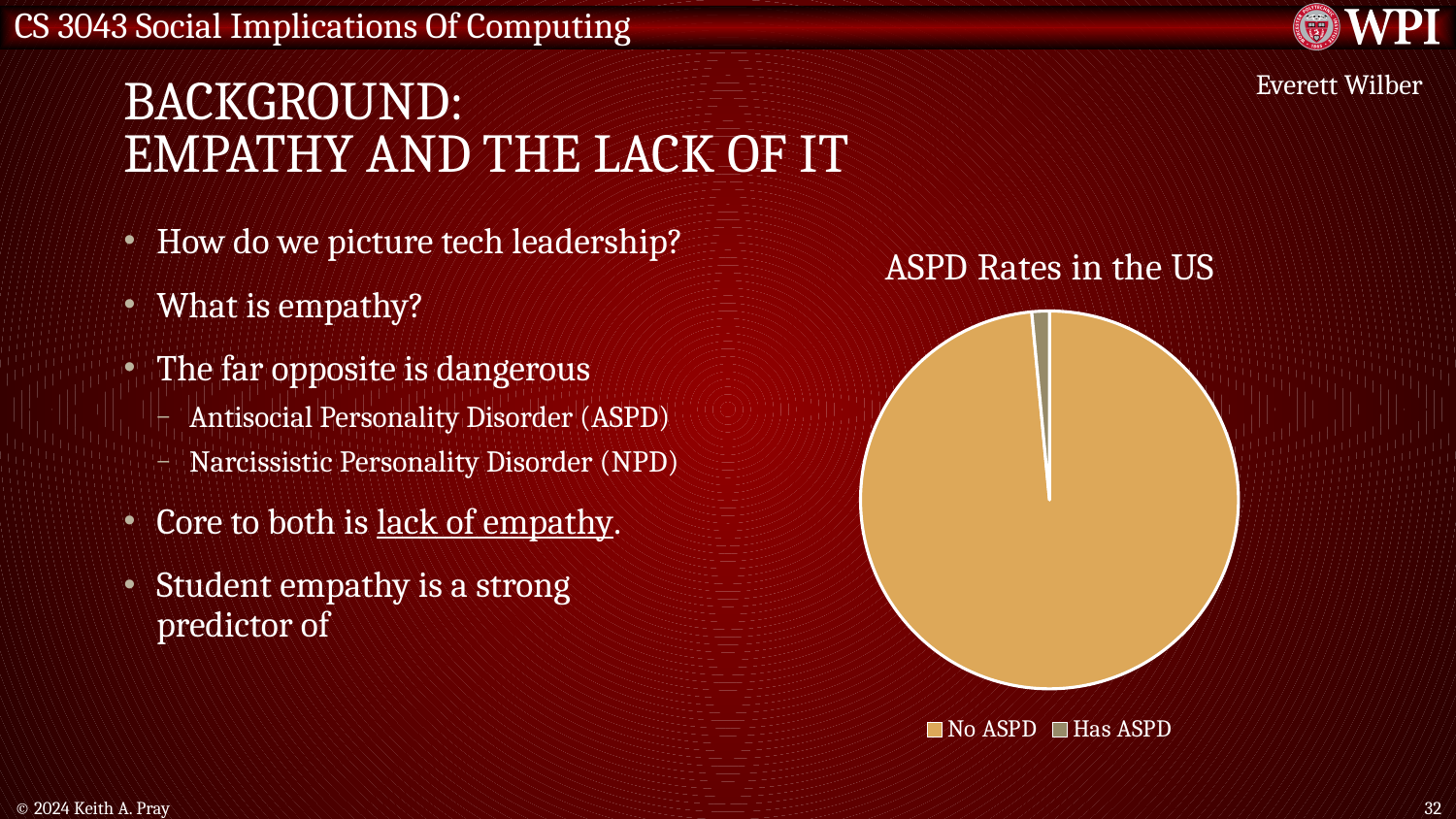
Which category takes up the smallest share of the pie chart? Has ASPD What are the two categories listed in the chart's legend? No ASPD and Has ASPD How many entries does the chart's legend list? 2 How many slices does the pie chart have? 2 Which slice is larger in the pie chart, No ASPD or Has ASPD? No ASPD Which category takes up the largest share of the pie chart? No ASPD What is the title of the chart on the slide? ASPD Rates in the US What kind of chart is shown on the slide? pie chart